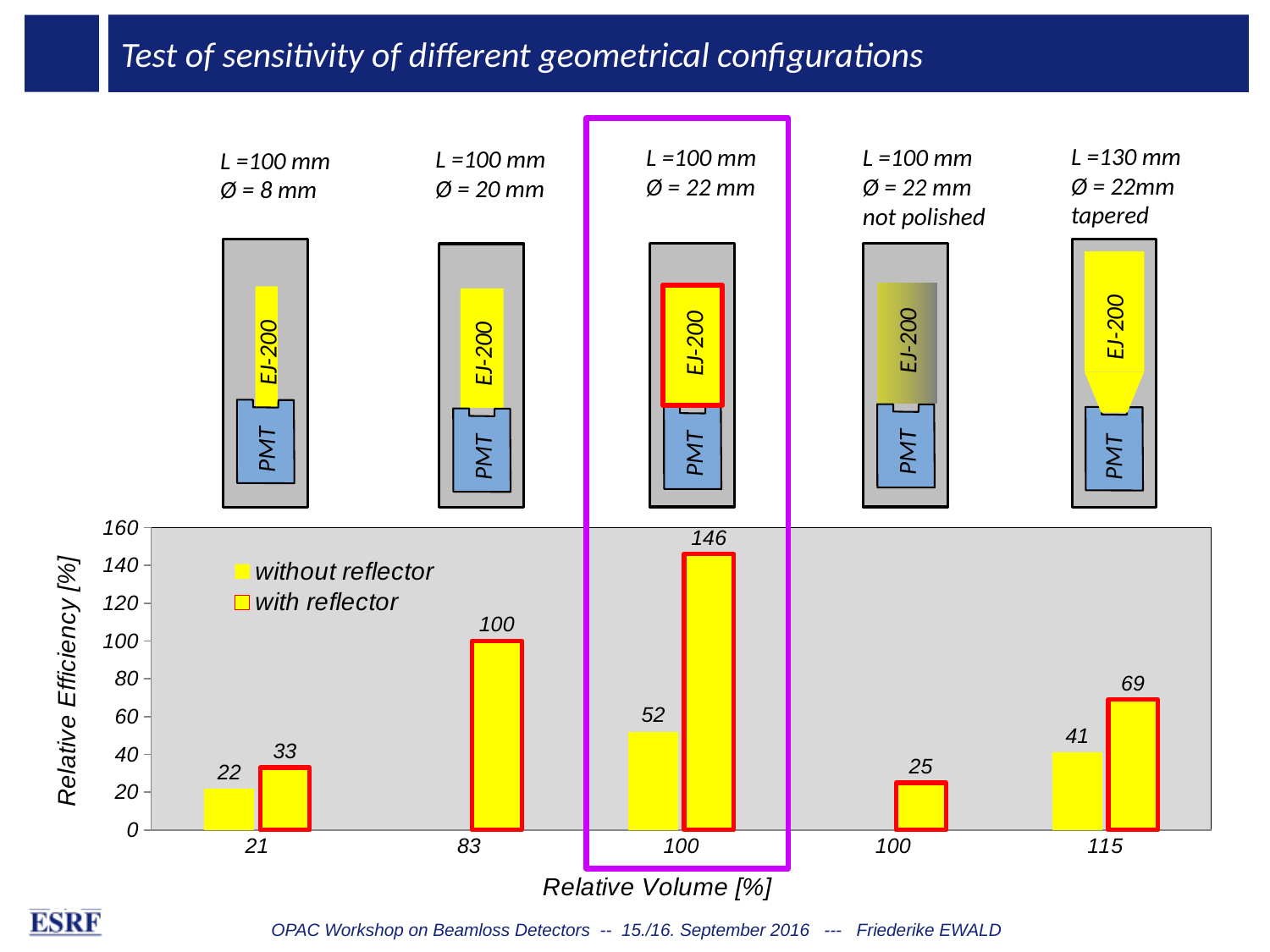
What is the 'without reflector' value for the tapered configuration with relative volume 115%? 41 What is the 'with reflector' value for the configuration with relative volume 83%? 100 Which configuration has the highest relative efficiency with reflector? L = 100 mm, Ø = 22 mm (polished), relative volume 100% Which configuration has the lowest 'with reflector' value? L = 100 mm, Ø = 22 mm, not polished For the tapered configuration (relative volume 115%), which is larger: the value with reflector or without reflector? with reflector What is the 'with reflector' value for the 'not polished' configuration (L = 100 mm, Ø = 22 mm)? 25 What is the 'with reflector' value for the highlighted configuration (L = 100 mm, Ø = 22 mm, polished)? 146 What is the difference between the 'with reflector' and 'without reflector' values for the highlighted Ø = 22 mm polished configuration? 94 How many series does the legend list? 2 What type of chart is shown on the slide? bar chart What is the label of the y-axis of the chart? Relative Efficiency [%] What is the 'without reflector' value for the configuration with relative volume 21%? 22